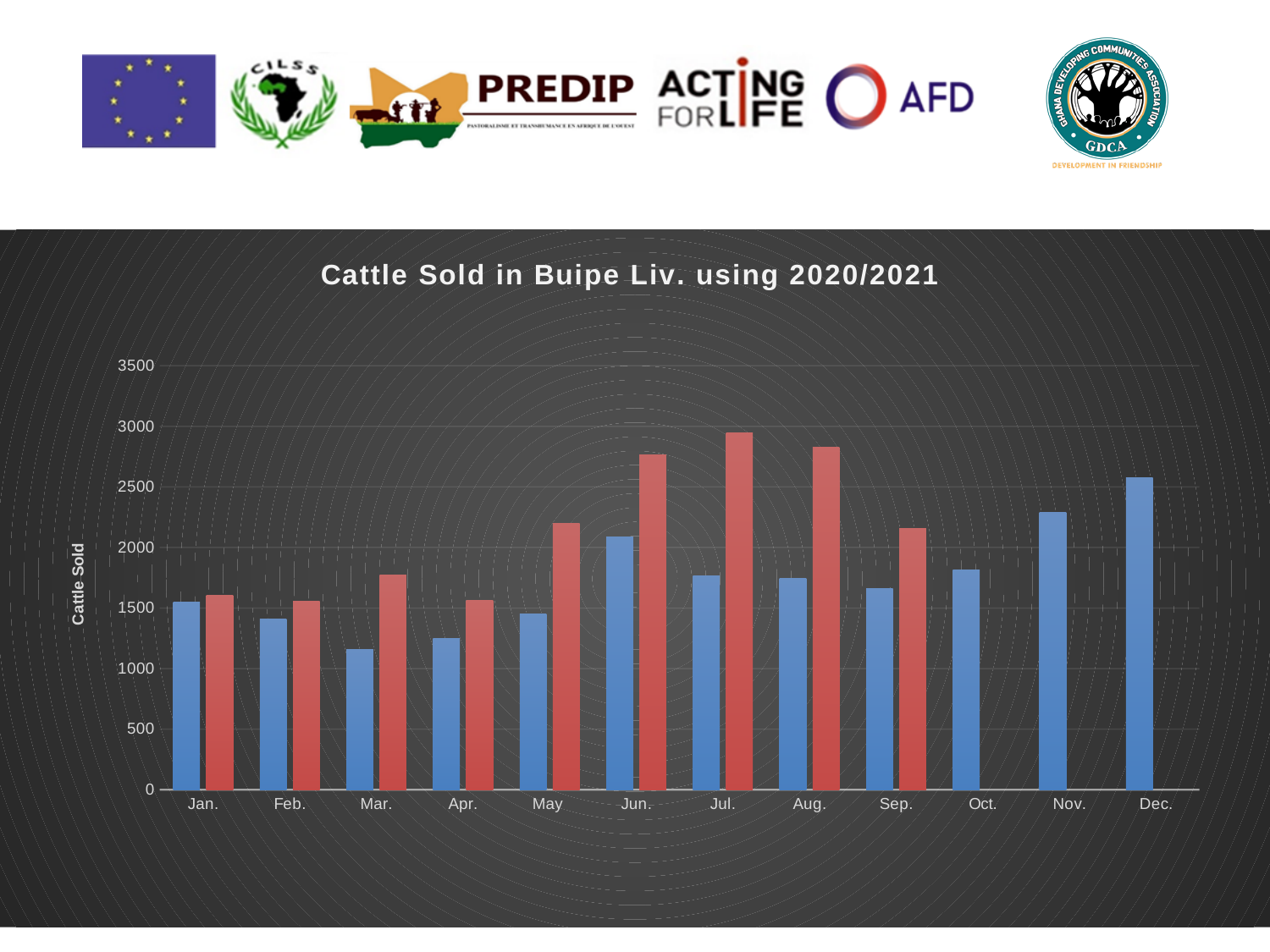
Is the blue bar for Mar. greater or less than 1500? less Which month has the shortest blue bar? Mar. Is the blue bar for Dec. greater or less than 2500? greater Do the blue bars rise or fall from Oct. to Dec.? rise Which is larger in Jun., the blue bar or the red bar? the red bar What kind of chart is shown on the slide? bar chart Which is larger, the blue bar for Nov. or the blue bar for Oct.? Nov. Is the red bar for Jul. greater or less than 2500? greater What is the label of the vertical axis? Cattle Sold How many months are shown on the x axis of the chart? 12 Which month has the tallest red bar? Jul. What is the title of the chart? Cattle Sold in Buipe Liv. using 2020/2021